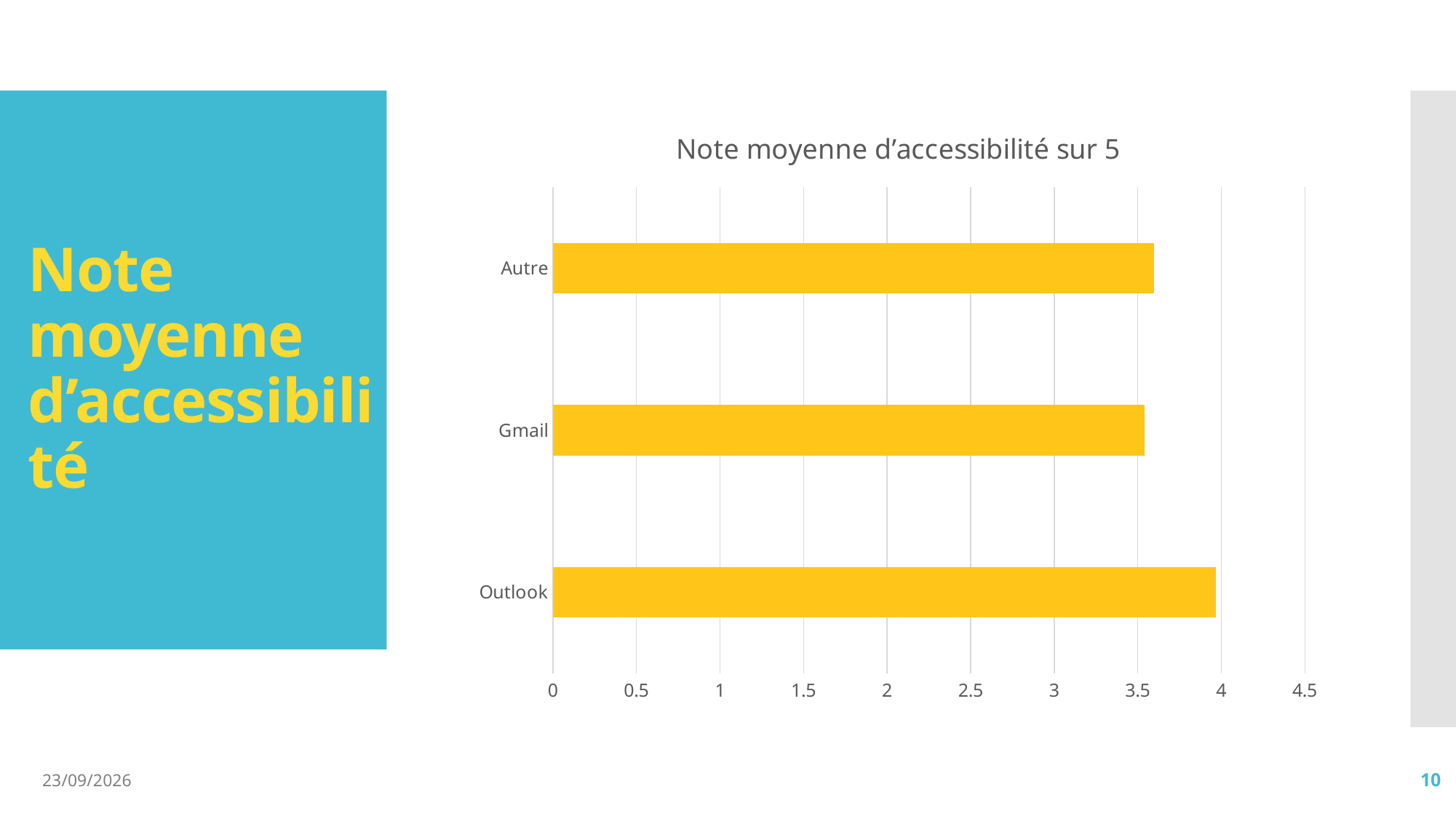
What is the title of the chart? Note moyenne d’accessibilité sur 5 Which has a higher value, Outlook or Autre? Outlook Is the value for Gmail greater or less than 3? greater Which has a higher value, Outlook or Gmail? Outlook What kind of chart is shown on the slide? bar chart What colour are the bars in the chart? yellow Is the value for Autre greater or less than 4? less Is the value for Outlook greater or less than 3.5? greater Which category has the highest average accessibility score? Outlook How many categories are plotted in the chart? 3